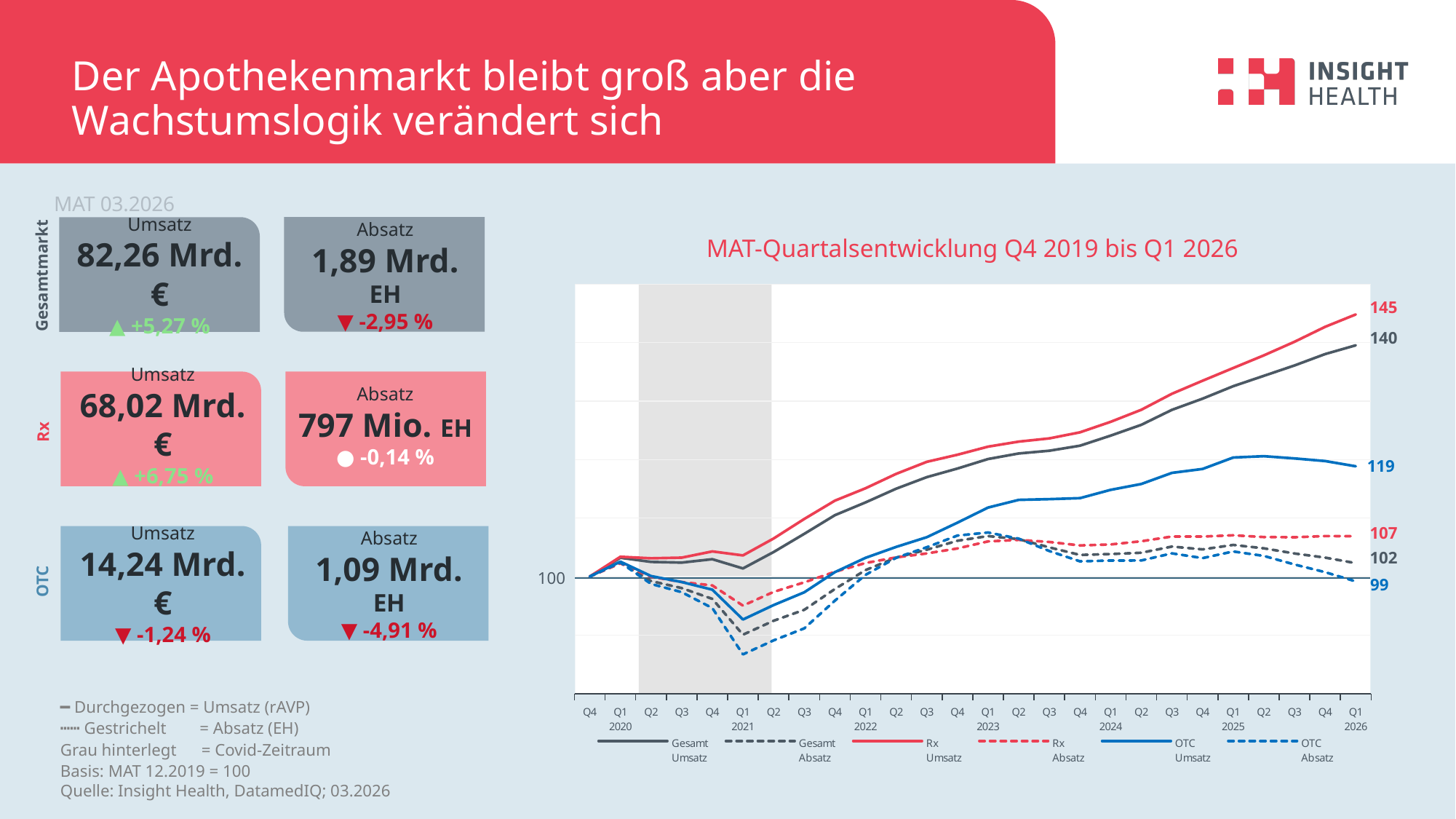
What is the difference between Rx Umsatz and Gesamt Umsatz at Q1 2026? 5 Which series has the lowest value at Q1 2026? OTC Absatz How many series does the chart legend list? 6 At Q1 2026, which is larger: Rx Absatz or Gesamt Absatz? Rx Absatz Which series has the highest value at Q1 2026? Rx Umsatz Is the value for OTC Umsatz at Q1 2021 greater or less than 100? less What is the value of Gesamt Umsatz at Q1 2026? 140 What is the value of Rx Umsatz at Q1 2026? 145 What is the title of the chart? MAT-Quartalsentwicklung Q4 2019 bis Q1 2026 What is the value of OTC Umsatz at Q1 2026? 119 What type of chart is shown on the slide? line chart What is the value of OTC Absatz at Q1 2026? 99